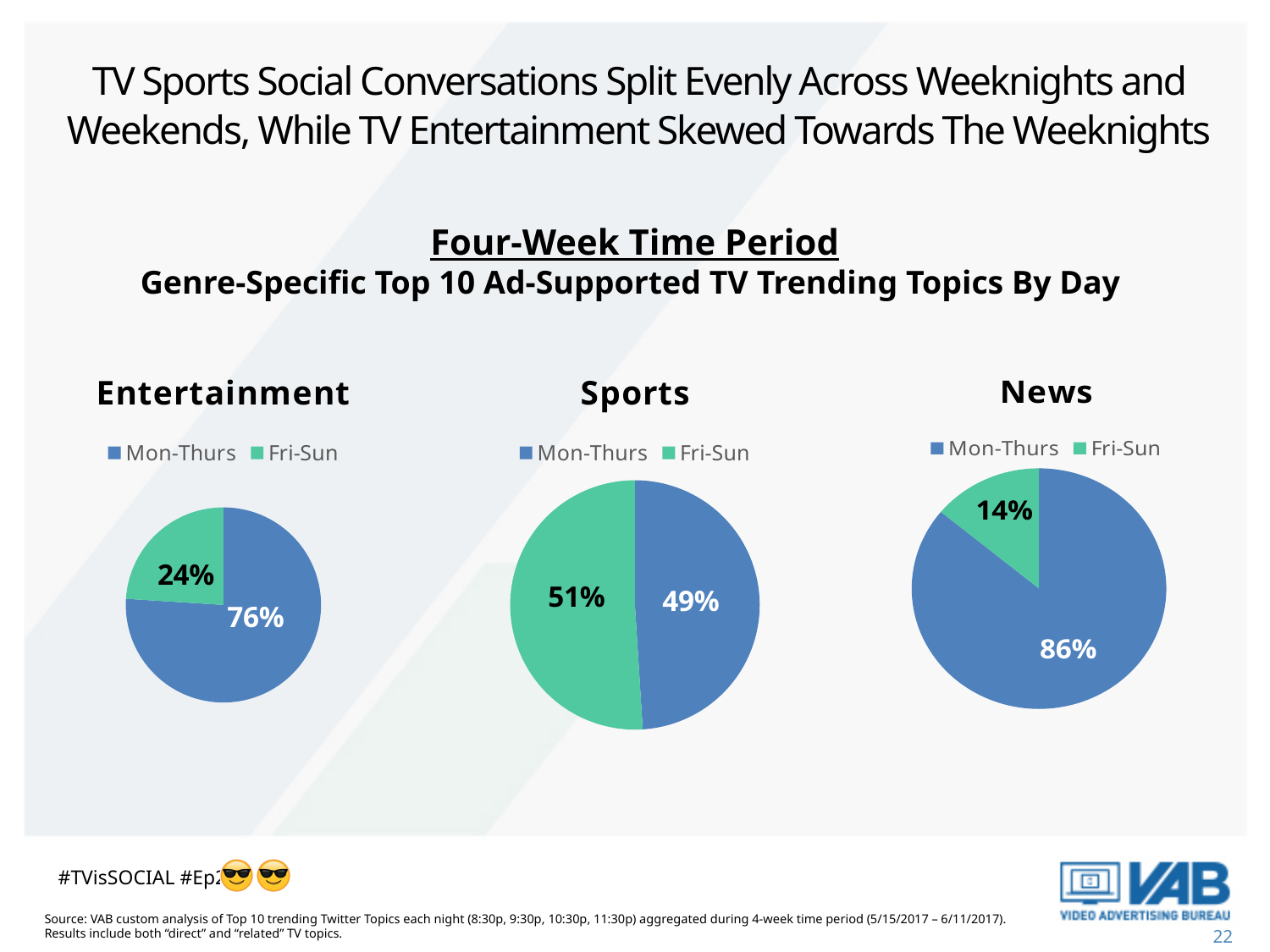
In the Entertainment pie chart, what share is Fri-Sun? 24% In the Entertainment pie chart, what share is Mon-Thurs? 76% In the Sports pie chart, what colour is the Fri-Sun slice? Green How many slices does the News pie chart have? 2 In the News pie chart, what share is Mon-Thurs? 86% In the Sports pie chart, what share is Mon-Thurs? 49% In the Entertainment pie chart, what is the difference between the Mon-Thurs and Fri-Sun shares? 52% What kind of chart is used for the Sports genre? Pie chart In the News pie chart, what share is Fri-Sun? 14% In the News pie chart, which slice is larger, Mon-Thurs or Fri-Sun? Mon-Thurs How many entries does the legend of the Entertainment pie chart list? 2 In the Sports pie chart, what share is Fri-Sun? 51%